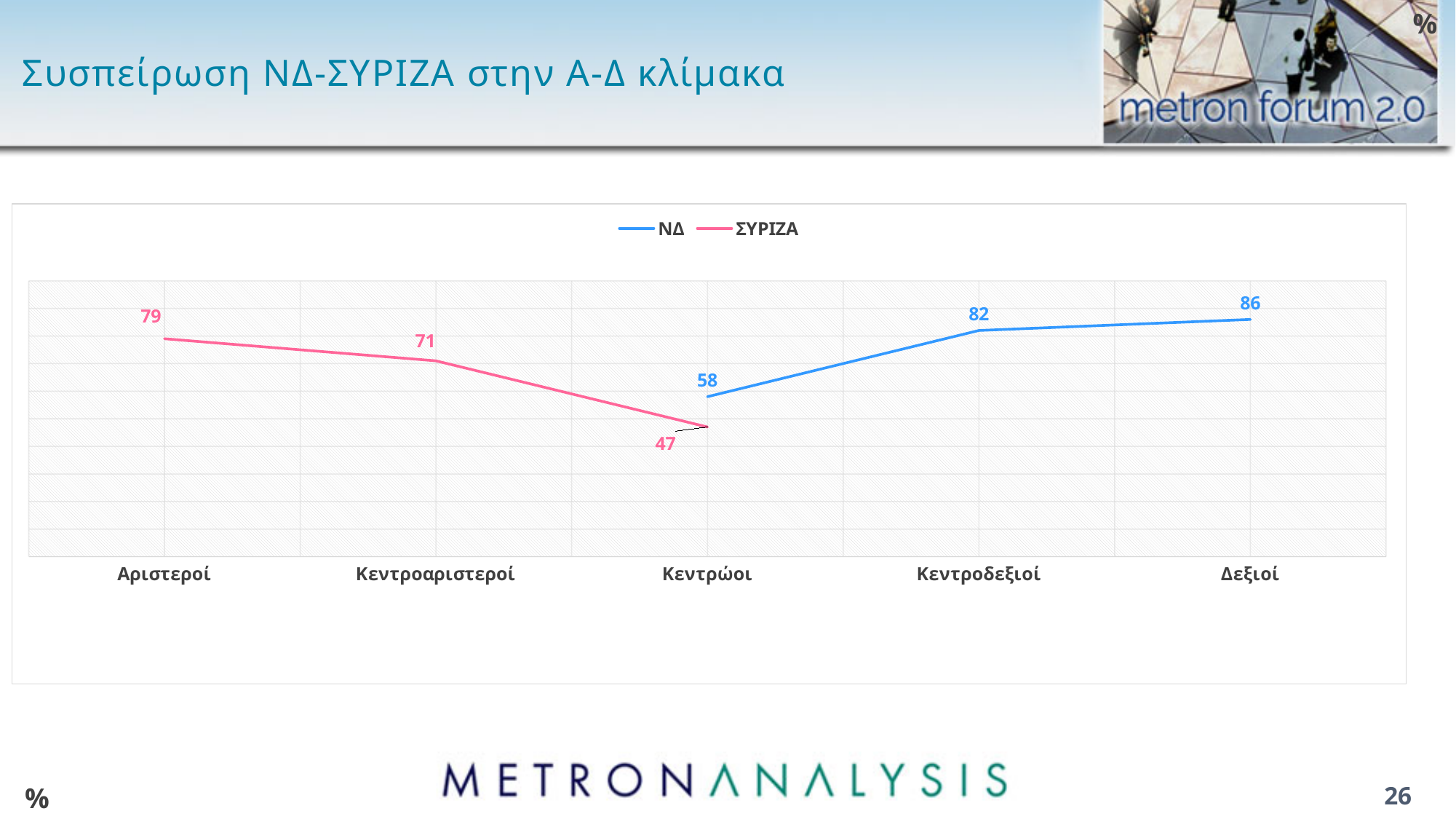
How many categories are shown on the x axis? 5 Among Κεντρώοι, which is larger: the value for ΝΔ or the value for ΣΥΡΙΖΑ? ΝΔ What is the difference between the ΝΔ value for Κεντροδεξιοί and the ΝΔ value for Κεντρώοι? 24 What kind of chart is shown on the slide? line chart Which category has the lowest value for ΣΥΡΙΖΑ? Κεντρώοι How many series does the legend list? 2 Which category has the highest value for ΝΔ? Δεξιοί What is the value for ΣΥΡΙΖΑ among Κεντροαριστεροί? 71 What is the value for ΣΥΡΙΖΑ among Κεντρώοι? 47 What is the value for ΝΔ among Κεντρώοι? 58 What is the value for ΝΔ among Δεξιοί? 86 What is the value for ΣΥΡΙΖΑ among Αριστεροί? 79